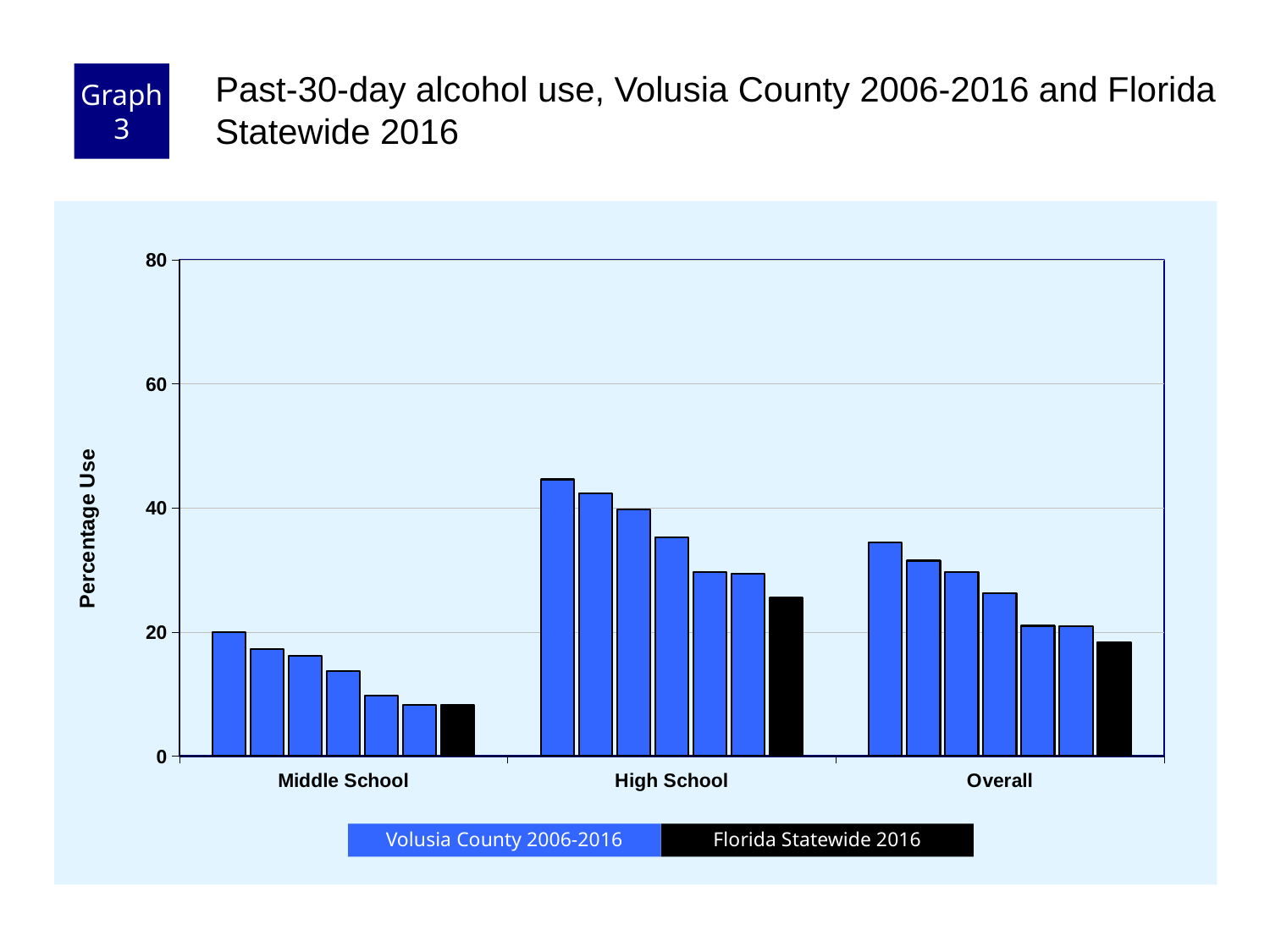
Which is larger, the Florida Statewide 2016 bar for High School or the Florida Statewide 2016 bar for Middle School? High School Within the Middle School group, do the Volusia County bars rise or fall from left to right? fall How many series does the legend list? 2 Which category has the lowest bars overall? Middle School What kind of chart is shown on the slide? bar chart Which category has the highest bars overall? High School Is the value of the tallest High School bar greater or less than 40? greater Is the Florida Statewide 2016 value for Middle School greater or less than 20? less Is the Florida Statewide 2016 value for High School greater or less than 20? greater Within the High School group, do the Volusia County bars rise or fall from left to right? fall How many school-level categories are shown on the x axis? 3 What is the label on the y axis? Percentage Use